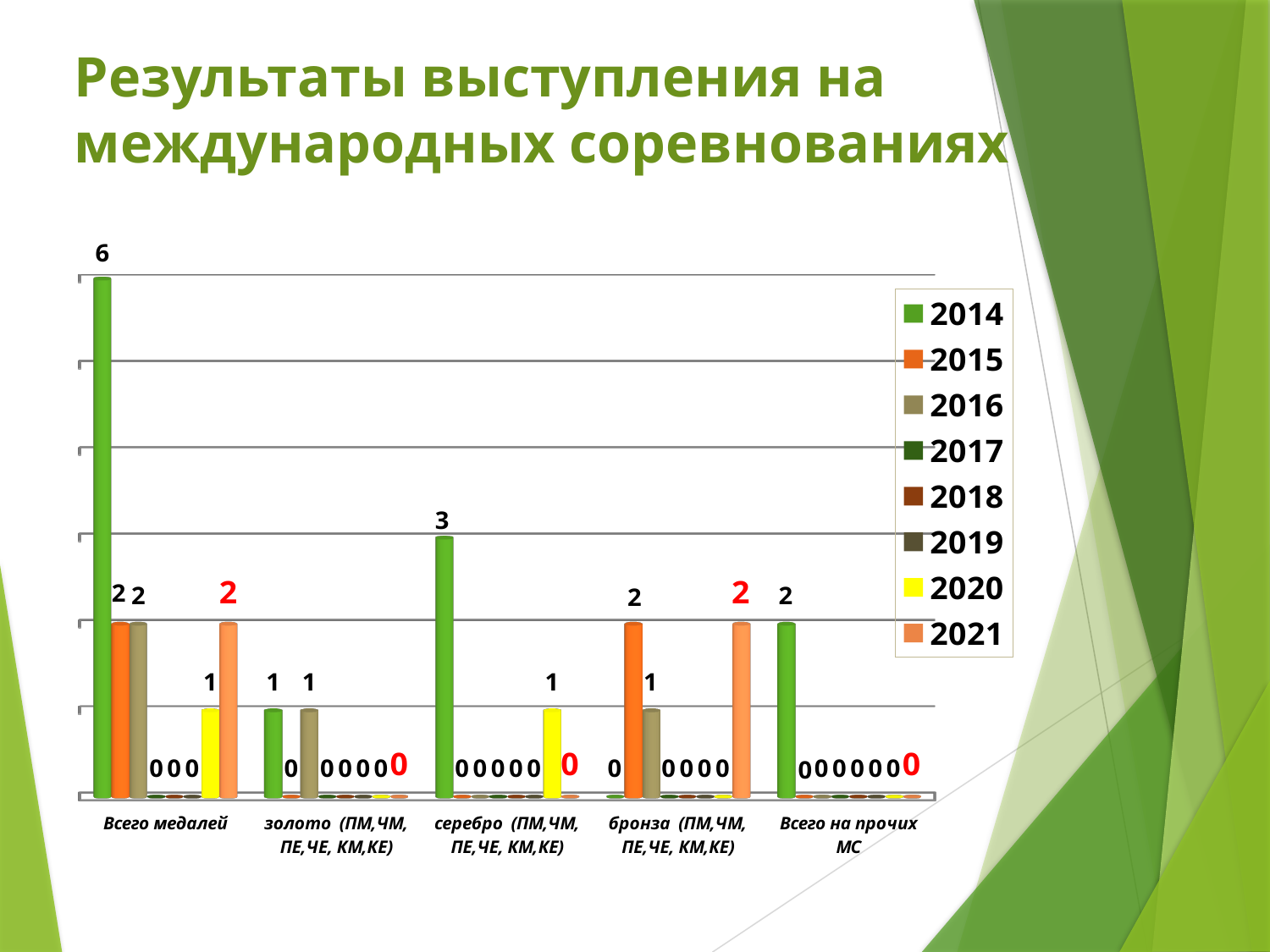
Which is larger in the 'бронза (ПМ,ЧМ, ПЕ,ЧЕ, КМ,КЕ)' category: the value for 2015 or the value for 2016? 2015 What kind of chart is shown on the slide? Bar chart What is the difference between the 2014 and 2015 values in the 'Всего медалей' category? 4 What is the value for 2014 in the 'серебро (ПМ,ЧМ, ПЕ,ЧЕ, КМ,КЕ)' category? 3 How many series does the legend list? 8 Which year has the highest value in the 'Всего медалей' category? 2014 What is the value for 2014 in the 'Всего на прочих МС' category? 2 What is the value for 2021 in the 'бронза (ПМ,ЧМ, ПЕ,ЧЕ, КМ,КЕ)' category? 2 What is the title of the slide containing the chart? Результаты выступления на международных соревнованиях How many categories are shown on the x axis? 5 What is the value for 2020 in the 'Всего медалей' category? 1 What is the value for 2014 in the 'Всего медалей' category? 6